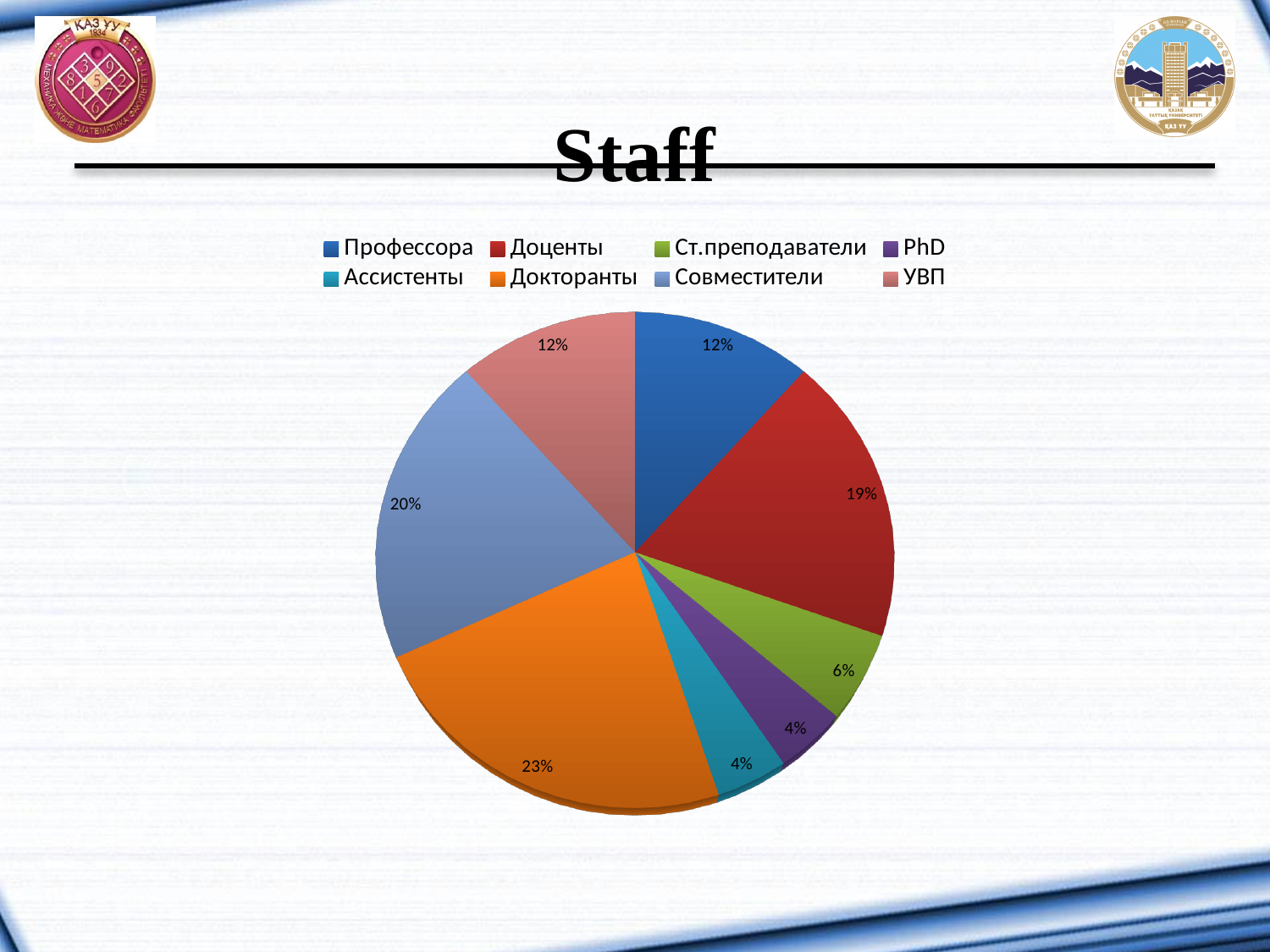
What colour is the slice for Докторанты? orange Which is larger, the share for Доценты or the share for Профессора? Доценты What share of staff are Докторанты? 23% What share of staff are Профессора? 12% How many categories does the legend list? 8 What share of staff are Доценты? 19% What type of chart is shown on the slide? pie chart What share of staff are Совместители? 20% What share of staff are Ст.преподаватели? 6% Which category has the largest share of the pie? Докторанты What is the title of the slide containing the chart? Staff What is the difference in percentage points between Докторанты and Совместители? 3